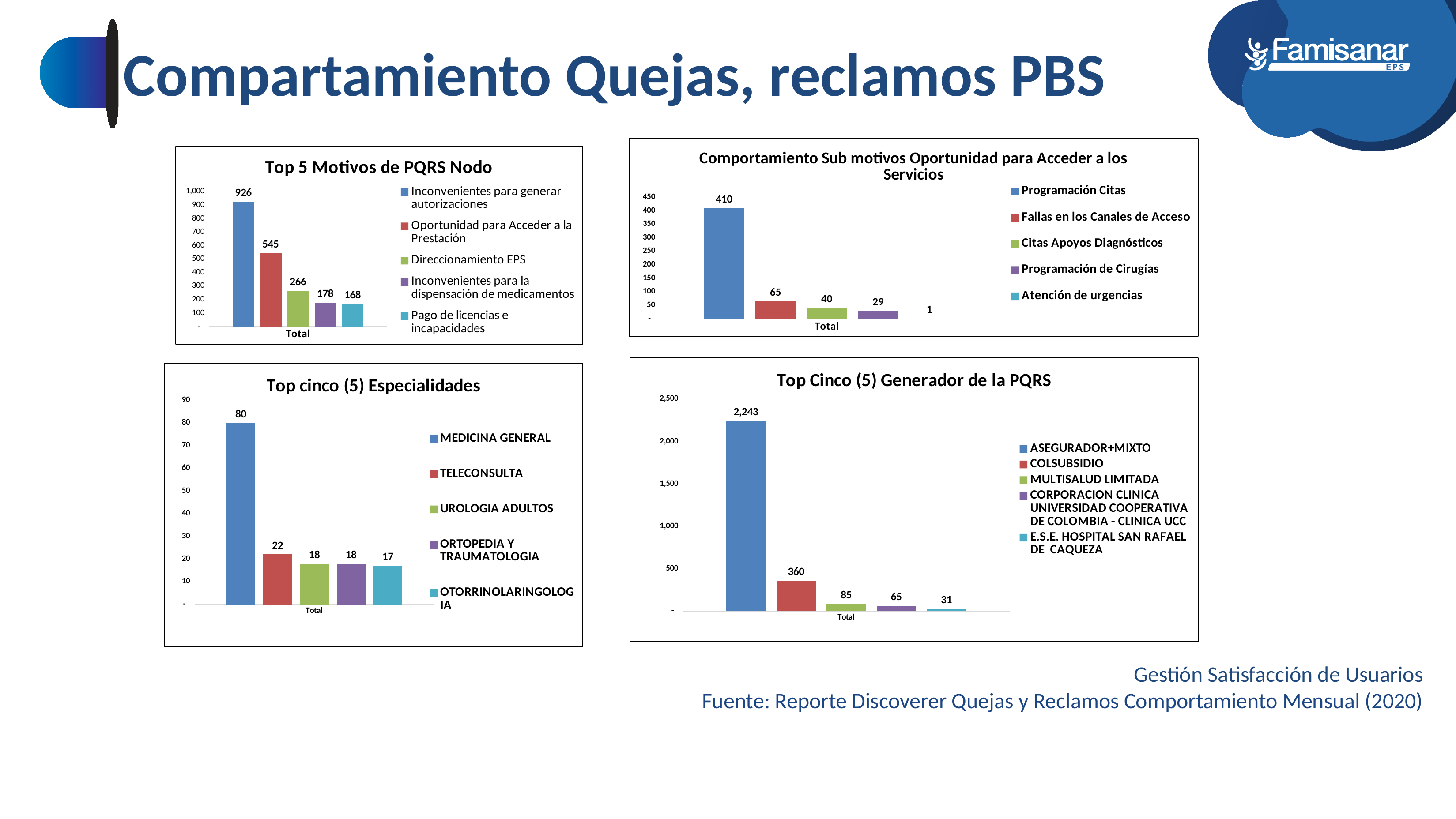
In the 'Top cinco (5) Especialidades' chart, what is the difference between 'MEDICINA GENERAL' and 'OTORRINOLARINGOLOGIA'? 63 In the 'Top cinco (5) Especialidades' chart, which is larger, 'MEDICINA GENERAL' or 'UROLOGIA ADULTOS'? MEDICINA GENERAL What kind of chart is 'Top Cinco (5) Generador de la PQRS'? Bar chart In the 'Comportamiento Sub motivos Oportunidad para Acceder a los Servicios' chart, which series has the highest value? Programación Citas In the 'Comportamiento Sub motivos Oportunidad para Acceder a los Servicios' chart, how many series does the legend list? 5 In the 'Comportamiento Sub motivos Oportunidad para Acceder a los Servicios' chart, what is the value for 'Fallas en los Canales de Acceso'? 65 In the 'Top 5 Motivos de PQRS Nodo' chart, what is the value for 'Inconvenientes para generar autorizaciones'? 926 In the 'Top 5 Motivos de PQRS Nodo' chart, which series has the lowest value? Pago de licencias e incapacidades In the 'Top Cinco (5) Generador de la PQRS' chart, what is the value for 'COLSUBSIDIO'? 360 In the 'Top 5 Motivos de PQRS Nodo' chart, what is the difference between 'Oportunidad para Acceder a la Prestación' and 'Direccionamiento EPS'? 279 In the 'Top Cinco (5) Generador de la PQRS' chart, what is the value for 'E.S.E. HOSPITAL SAN RAFAEL DE CAQUEZA'? 31 In the 'Top cinco (5) Especialidades' chart, what is the value for 'TELECONSULTA'? 22